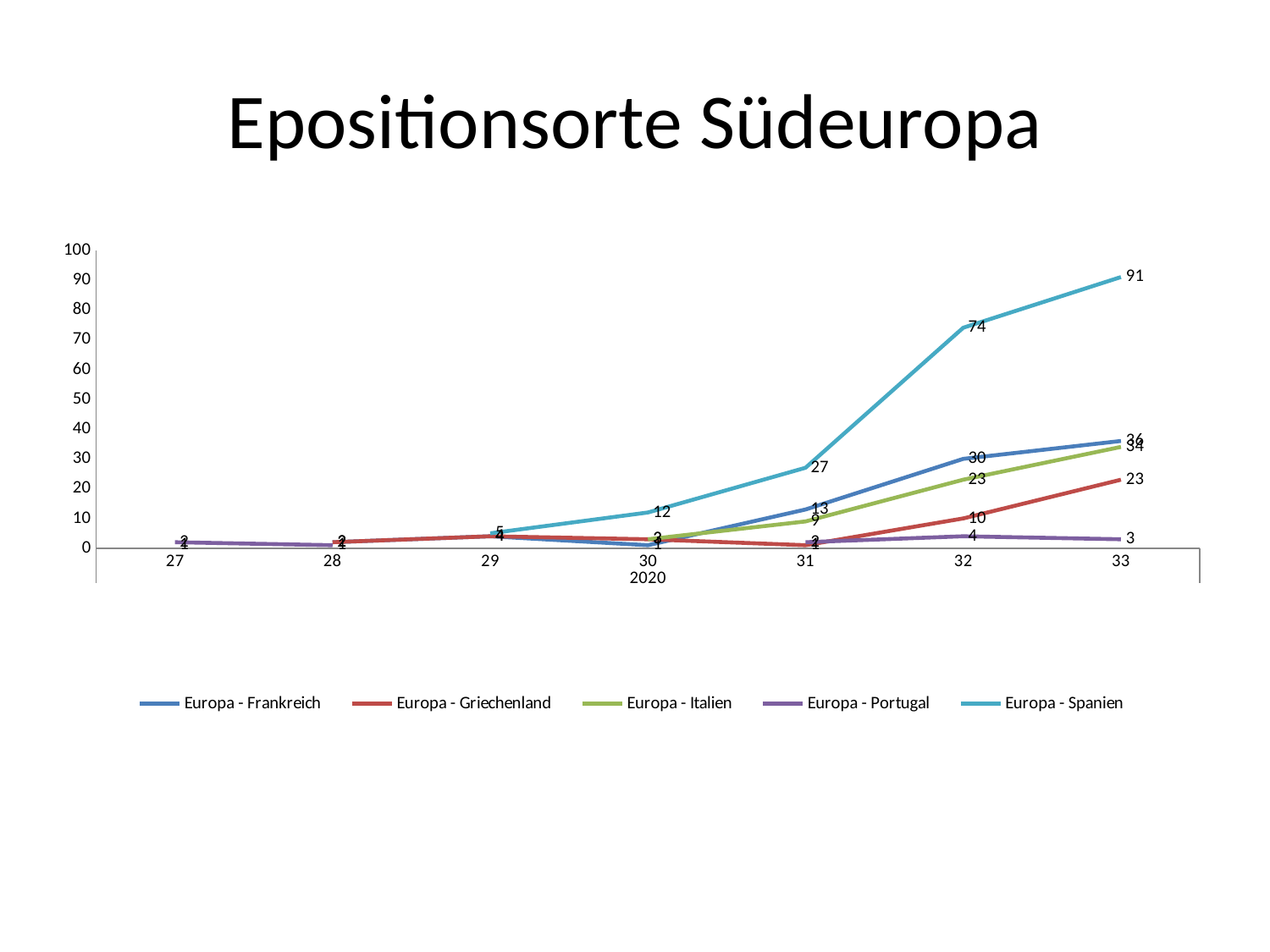
How many series does the legend list? 5 What is the value for Europa - Spanien in week 33? 91 What is the value for Europa - Frankreich in week 32? 30 In week 32, which is larger: the value for Europa - Frankreich or for Europa - Italien? Europa - Frankreich What is the value for Europa - Spanien in week 32? 74 How many week values are shown along the x axis? 7 Which series has the highest value in week 33? Europa - Spanien What is the value for Europa - Portugal in week 33? 3 Does the value for Europa - Spanien rise or fall from week 30 to week 33? rise By how much did the value for Europa - Spanien increase from week 32 to week 33? 17 What kind of chart is shown on the slide? line chart What is the value for Europa - Griechenland in week 33? 23